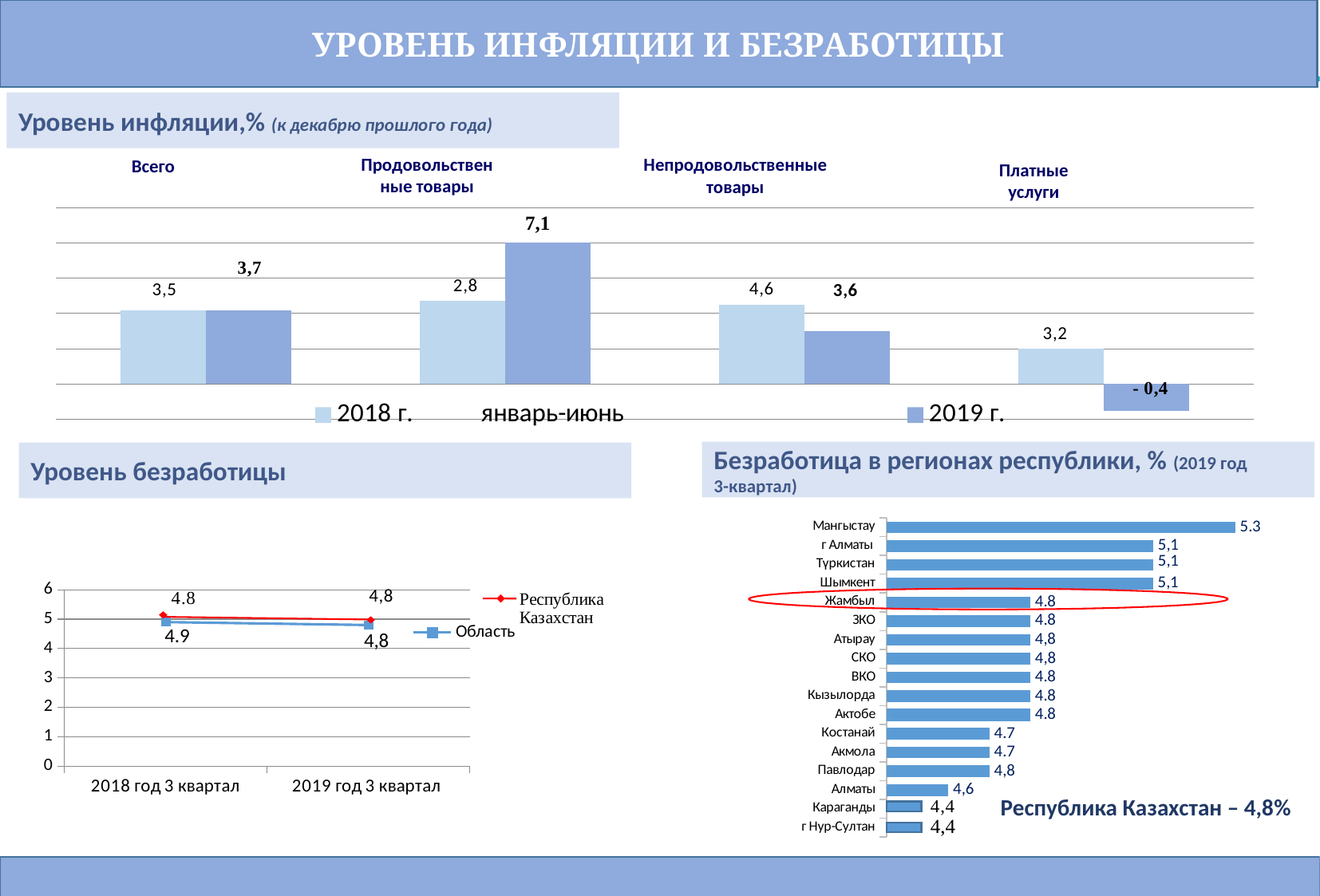
In the Уровень безработицы chart, what is the value for Область in 2018 год 3 квартал? 4.9 In the Безработица в регионах республики chart, which region has the highest value? Мангыстау In the Уровень безработицы chart, what is the value for Республика Казахстан in 2019 год 3 квартал? 4.8 In the inflation chart (Уровень инфляции,%), what is the 2019 г. value for Продовольственные товары? 7,1 In the Безработица в регионах республики chart, what is the value for Жамбыл? 4.8 In the inflation chart (Уровень инфляции,%), how many series does the legend list? 2 In the Безработица в регионах республики chart, how many regions are plotted? 17 In the inflation chart (Уровень инфляции,%), what is the 2019 г. value for Платные услуги? - 0,4 What kind of chart is the Уровень безработицы chart at the bottom left? Line chart In the inflation chart (Уровень инфляции,%), which category has the highest 2019 г. value? Продовольственные товары In the inflation chart (Уровень инфляции,%), what is the difference between the 2019 г. and 2018 г. values for Продовольственные товары? 4,3 In the inflation chart (Уровень инфляции,%), what is the 2018 г. value for Непродовольственные товары? 4,6